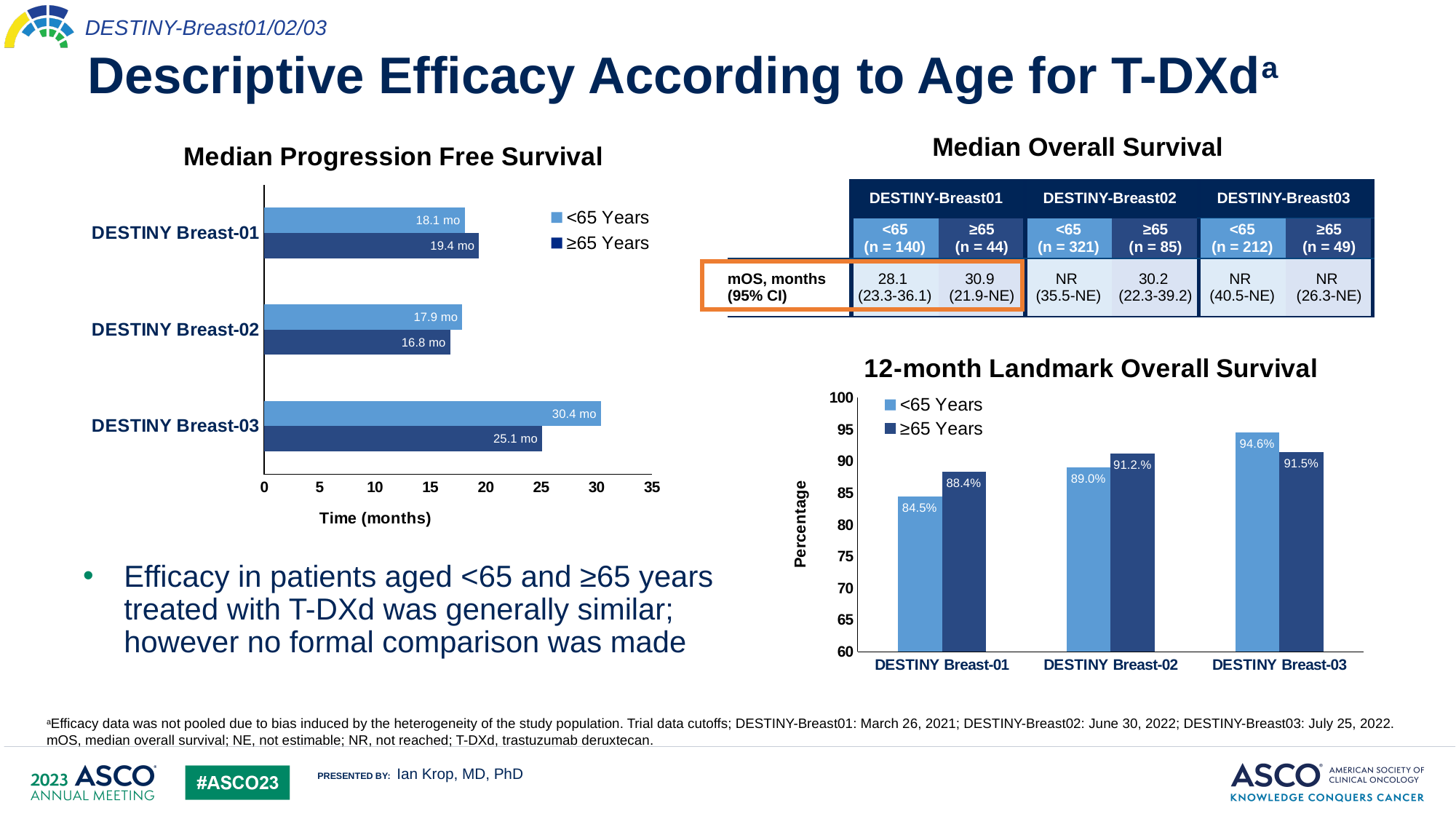
In the Median Progression Free Survival chart, which trial has the lowest value for the ≥65 Years series? DESTINY Breast-02 In the Median Progression Free Survival chart, which is larger for DESTINY Breast-02: the <65 Years value or the ≥65 Years value? <65 Years In the Median Progression Free Survival chart, what is the difference between the <65 Years and ≥65 Years values for DESTINY Breast-03? 5.3 mo In the Median Progression Free Survival chart, what is the value for DESTINY Breast-01 in the ≥65 Years series? 19.4 mo In the Median Progression Free Survival chart, which trial has the highest value for the <65 Years series? DESTINY Breast-03 In the Median Progression Free Survival chart, what is the value for DESTINY Breast-03 in the <65 Years series? 30.4 mo In the 12-month Landmark Overall Survival chart, what is the difference between the ≥65 Years and <65 Years values for DESTINY Breast-01? 3.9% In the 12-month Landmark Overall Survival chart, do the <65 Years values rise or fall from DESTINY Breast-01 to DESTINY Breast-03? Rise In the 12-month Landmark Overall Survival chart, what is the value for DESTINY Breast-03 in the ≥65 Years series? 91.5% In the 12-month Landmark Overall Survival chart, how many series does the legend list? 2 In the 12-month Landmark Overall Survival chart, what is the value for DESTINY Breast-01 in the <65 Years series? 84.5% What kind of chart is the Median Progression Free Survival chart? Bar chart